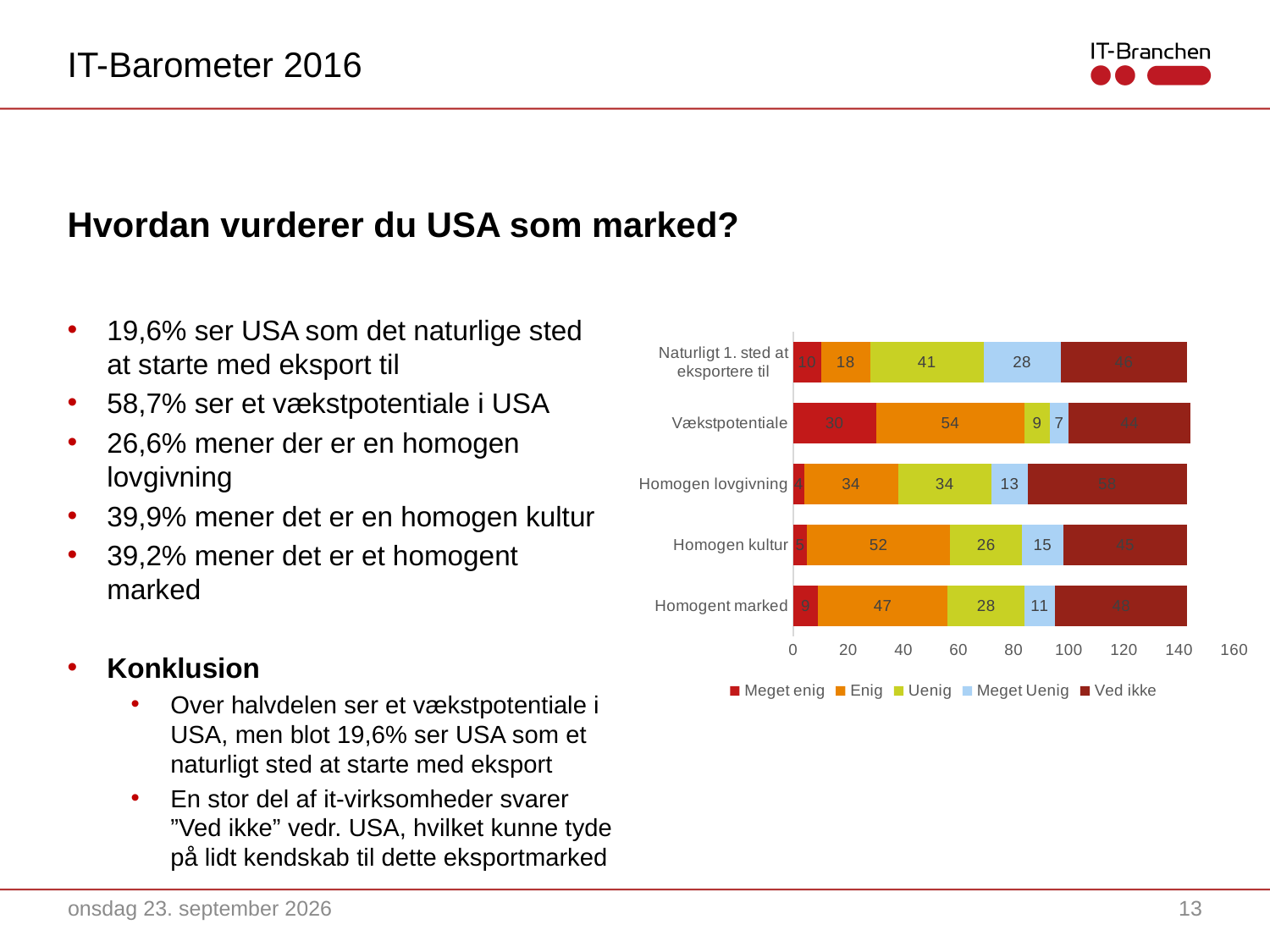
What kind of chart is shown on the slide? Stacked bar chart What is the difference between the 'Enig' values for 'Homogen kultur' and 'Homogent marked'? 5 What is the 'Meget Uenig' value for 'Homogen lovgivning'? 13 Which category has the highest 'Enig' value? Vækstpotentiale How many series does the chart legend list? 5 What is the 'Enig' value for 'Vækstpotentiale'? 54 Which category has the lowest 'Meget enig' value? Homogen lovgivning What is the 'Meget enig' value for 'Vækstpotentiale'? 30 Which series is listed first in the chart legend? Meget enig What is the 'Uenig' value for 'Naturligt 1. sted at eksportere til'? 41 Which has the larger 'Meget Uenig' value: 'Naturligt 1. sted at eksportere til' or 'Homogen kultur'? Naturligt 1. sted at eksportere til How many categories are plotted on the y axis of the chart? 5